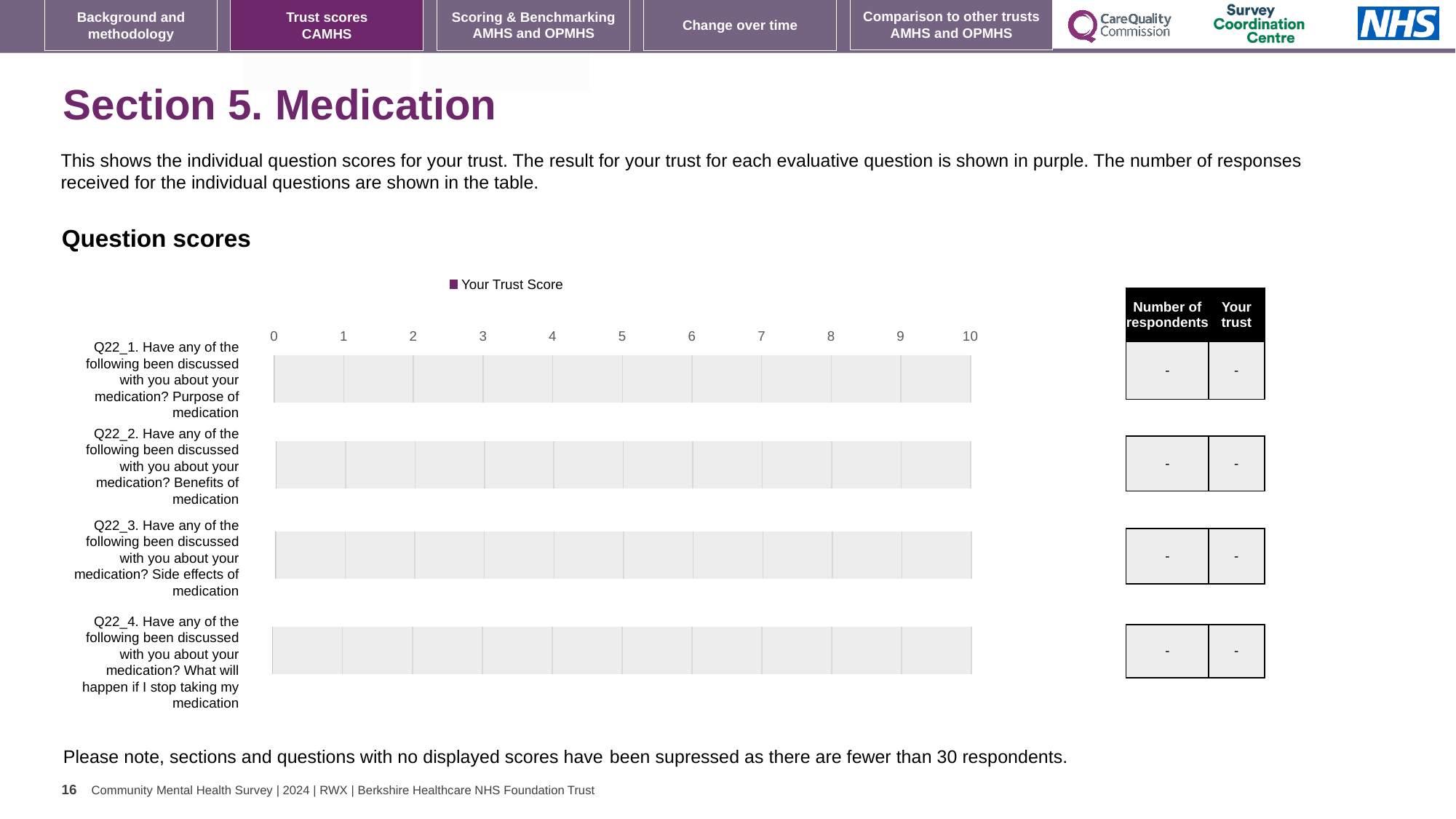
What is the legend entry shown on the "Question scores" chart? Your Trust Score How many questions (categories) are listed on the "Question scores" chart? 4 How many series does the legend of the "Question scores" chart list? 1 What value is shown in the "Number of respondents" column for Q22_4 (What will happen if I stop taking my medication)? - What value is shown in the "Your trust" column for Q22_3 (Side effects of medication)? - What is the highest value shown on the x axis of the "Question scores" chart? 10 What value is shown in the "Your trust" column for Q22_1 (Purpose of medication)? - What kind of chart is shown under "Question scores"? bar chart